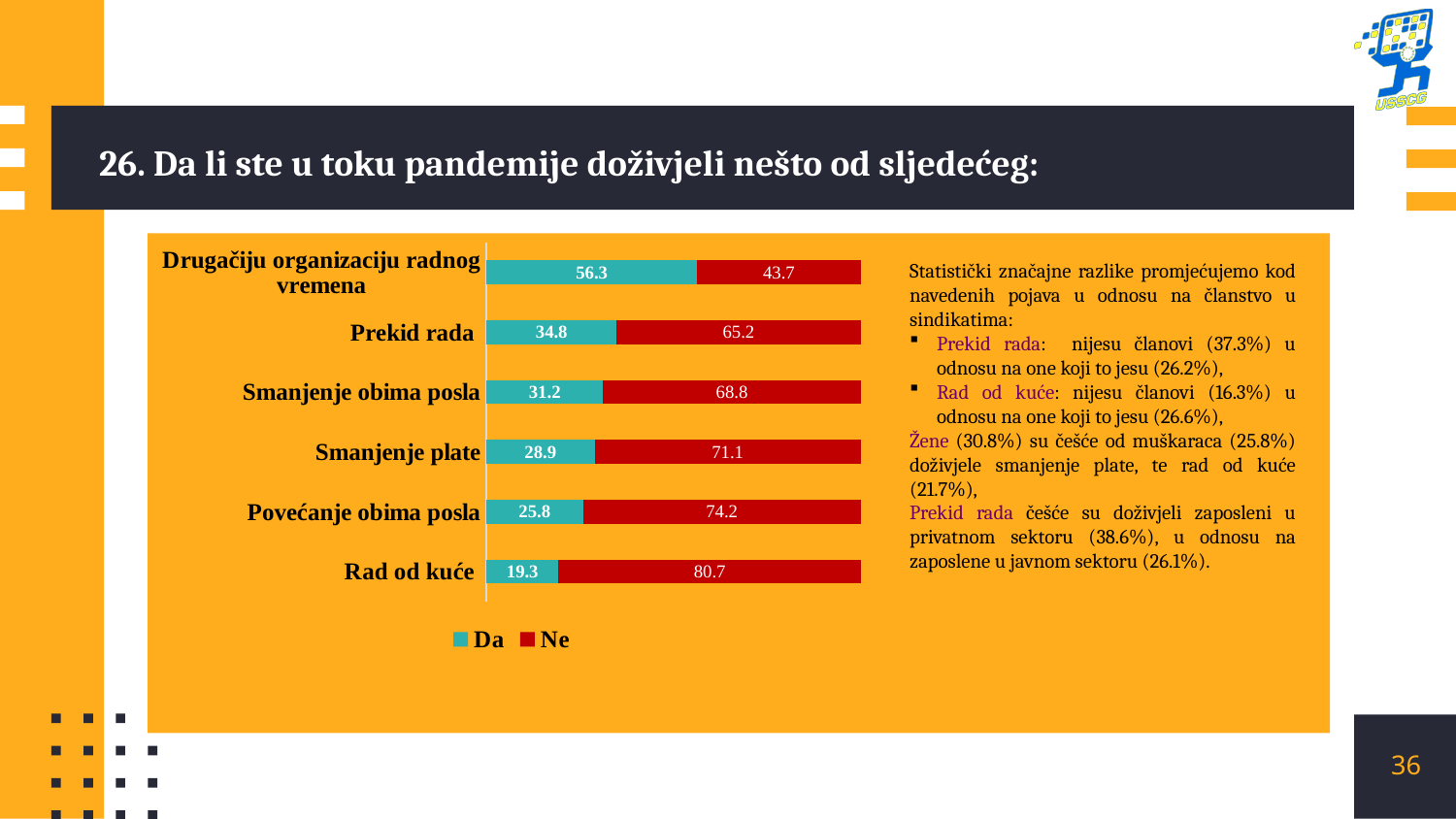
Which category has the lowest 'Da' value? Rad od kuće What is the difference between the 'Ne' and 'Da' values for 'Povećanje obima posla'? 48.4 Which is larger: the 'Da' value for 'Smanjenje obima posla' or the 'Da' value for 'Smanjenje plate'? Smanjenje obima posla What is the 'Ne' value for 'Rad od kuće'? 80.7 Which category has the highest 'Da' value? Drugačiju organizaciju radnog vremena How many categories are shown in the chart? 6 What is the total of the stacked bar for 'Prekid rada'? 100 What is the 'Da' value for 'Prekid rada'? 34.8 How many series does the legend list? 2 What are the two series named in the legend? Da and Ne What is the 'Da' value for 'Smanjenje plate'? 28.9 What kind of chart is shown on the slide? Stacked bar chart